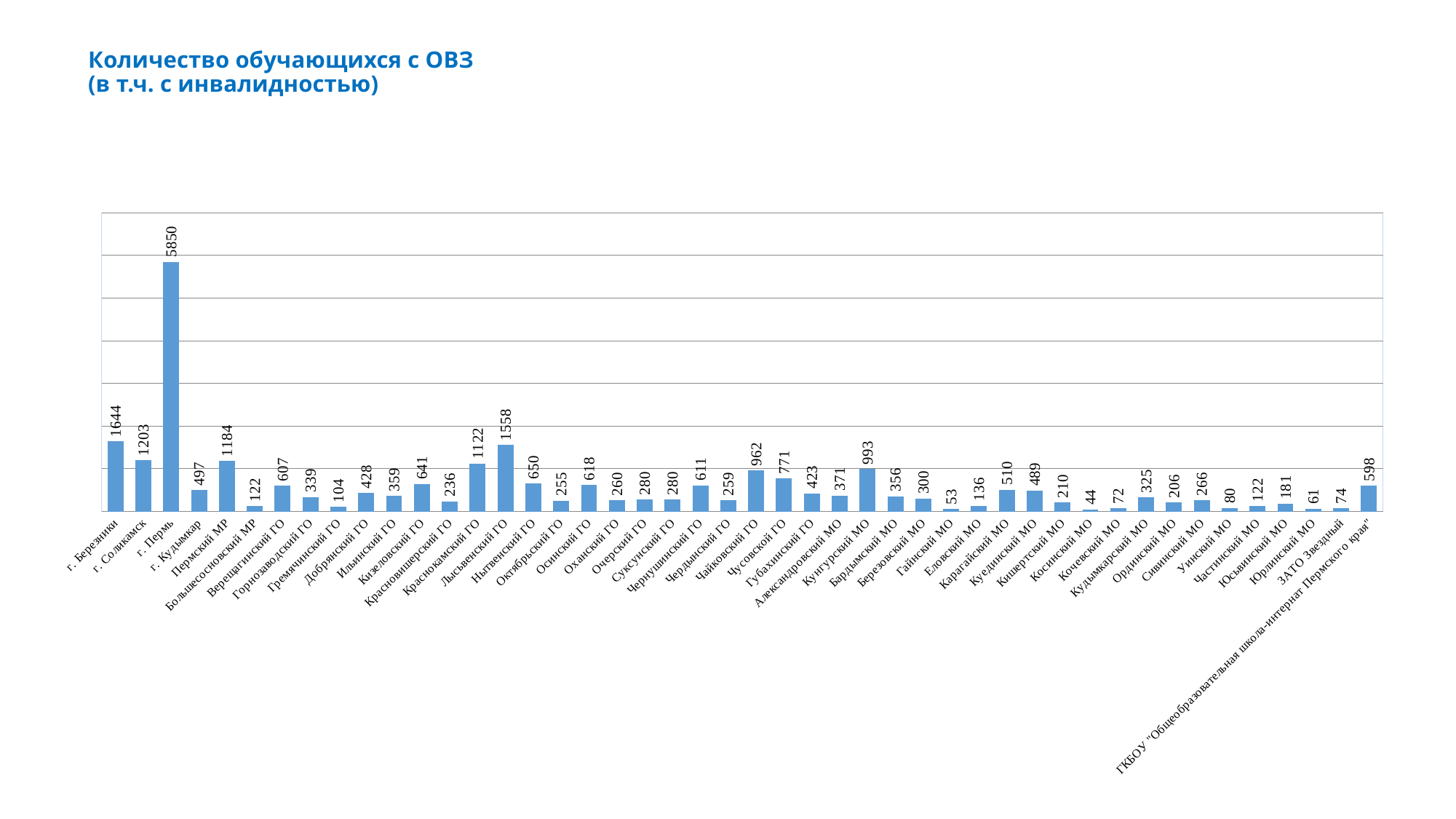
Which is larger, the value for Краснокамский ГО or the value for Пермский МР? Пермский МР Which category has the highest value? г. Пермь Which is larger, the value for Карагайский МО or the value for Кишертский МО? Карагайский МО What is the difference between the values for г. Березники and г. Соликамск? 441 What kind of chart is shown on the slide? Bar chart How many categories are shown on the x axis? 46 What is the value for Лысьвенский ГО? 1558 Which category has the lowest value? Косинский МО What is the difference between the values for Чайковский ГО and Чусовской ГО? 191 What is the value for г. Пермь? 5850 What is the value for Кунгурский МО? 993 What is the value for ЗАТО Звездный? 74